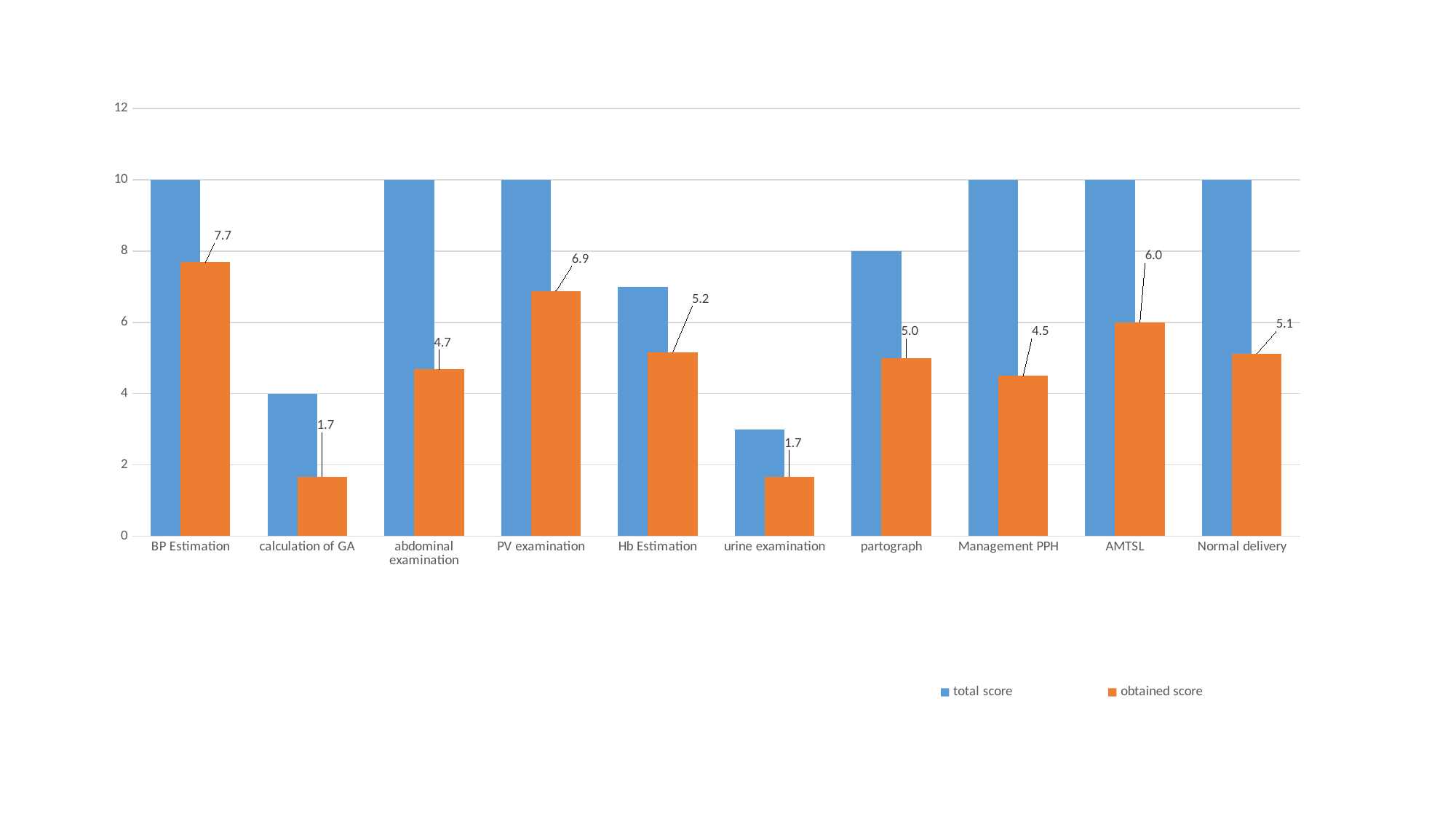
How many categories are shown on the x axis? 10 What is the difference between the total score and the obtained score for AMTSL? 4.0 Which category has the highest obtained score? BP Estimation What is the obtained score for AMTSL? 6.0 What kind of chart is shown on the slide? bar chart What is the obtained score for BP Estimation? 7.7 What is the difference between the obtained scores for BP Estimation and Normal delivery? 2.6 Which category has the lowest total score? urine examination Is the total score for Hb Estimation greater or less than 6? greater How many series does the legend list? 2 What is the total score for partograph? 8 Which has a higher obtained score, PV examination or Hb Estimation? PV examination